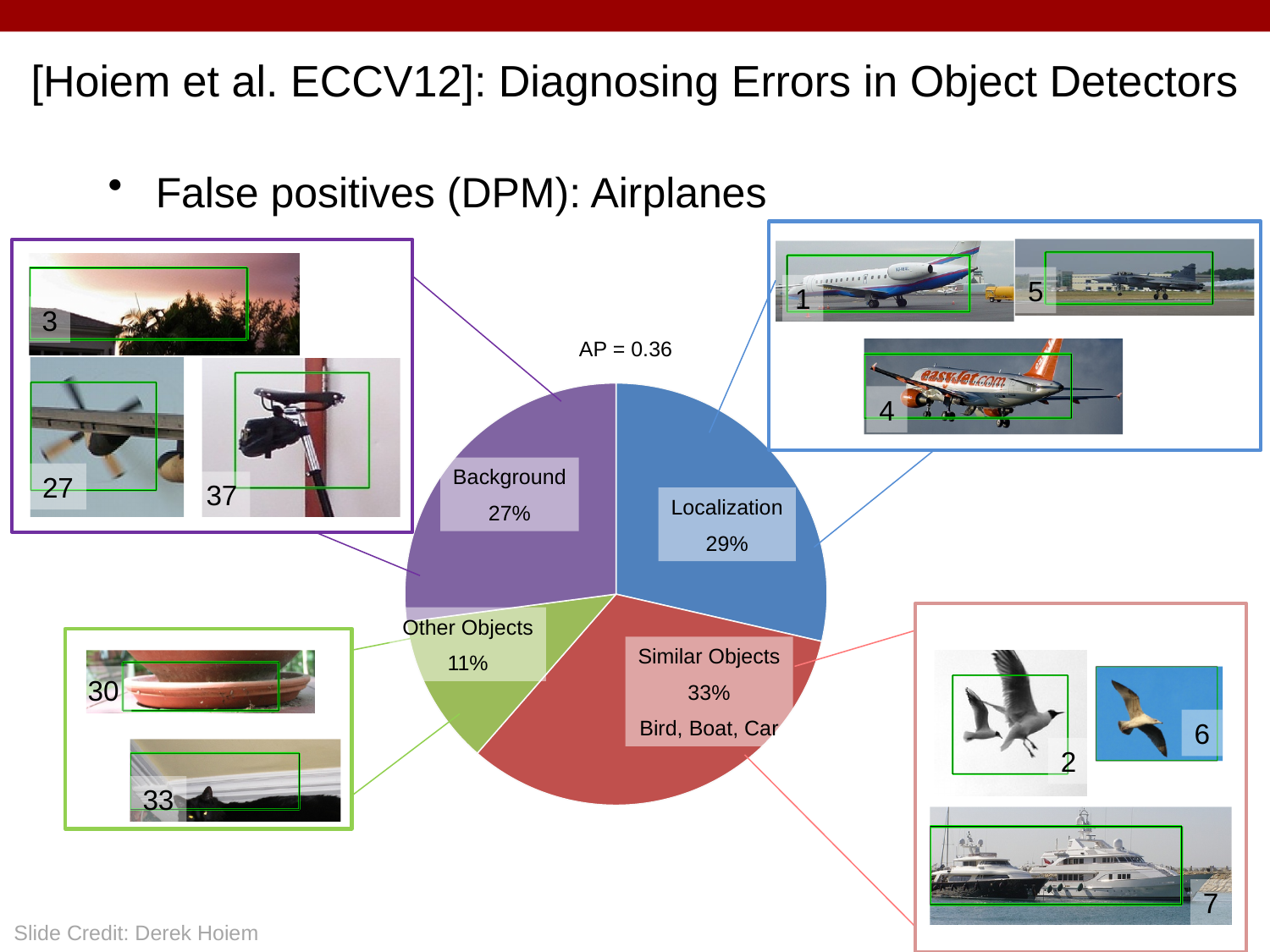
What percentage of false positives is attributed to Background? 27% Which is larger, the Localization share or the Background share? Localization What percentage of false positives is attributed to Other Objects? 11% Which similar object classes are listed on the Similar Objects slice? Bird, Boat, Car What percentage of false positives is attributed to Similar Objects? 33% Which category accounts for the smallest share of false positives? Other Objects What AP value is printed next to the pie chart? AP = 0.36 What percentage of false positives is attributed to Localization? 29% Which category accounts for the largest share of false positives? Similar Objects What is the difference in percentage points between Similar Objects and Other Objects? 22 What kind of chart is shown on the slide? pie chart How many categories does the pie chart have? 4